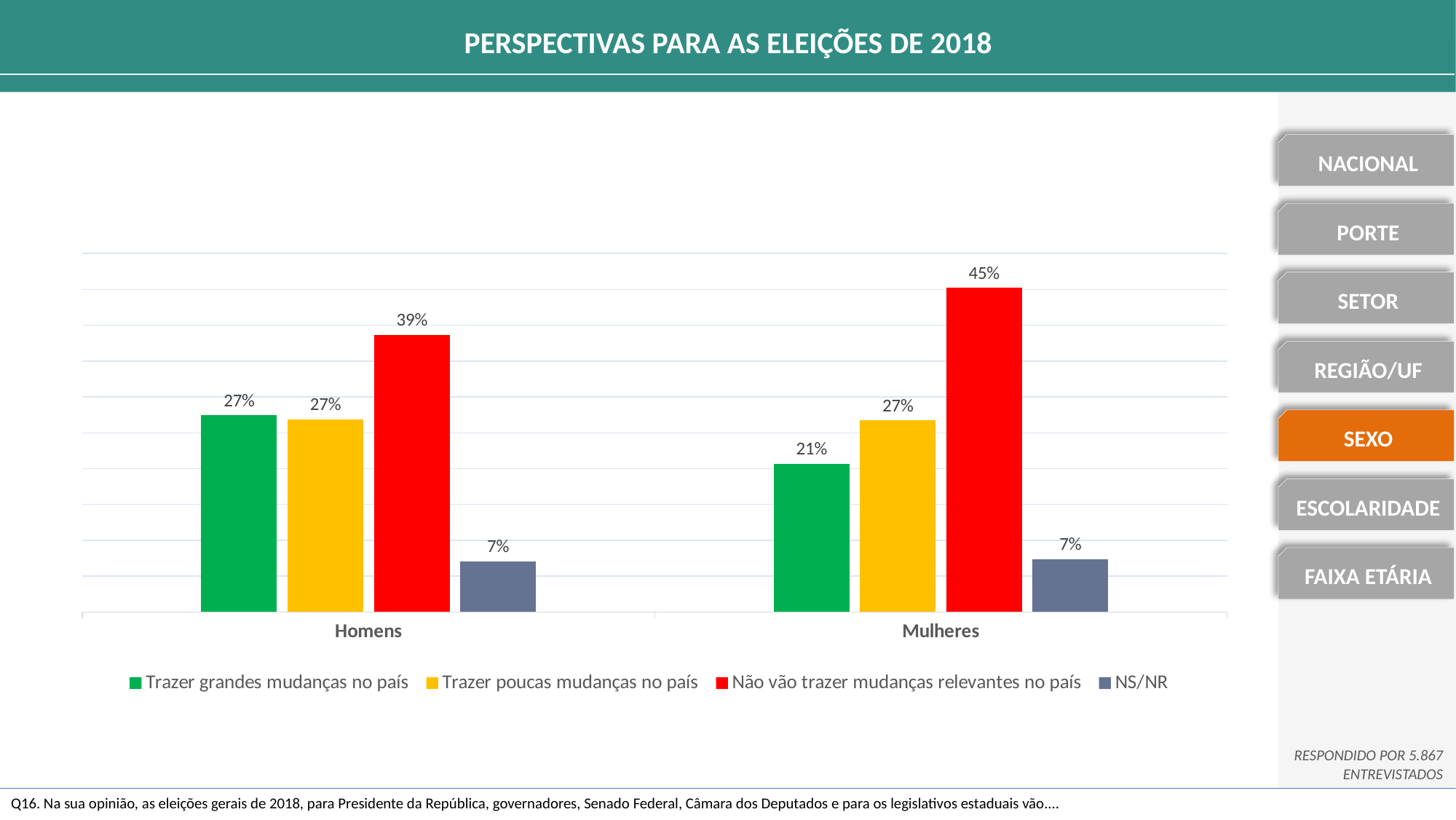
Which series has the highest value for Mulheres? Não vão trazer mudanças relevantes no país What is the value for "Não vão trazer mudanças relevantes no país" among Homens? 39% What is the value for NS/NR among Mulheres? 7% Which group has the larger value for "Trazer grandes mudanças no país", Homens or Mulheres? Homens What is the difference between the "Não vão trazer mudanças relevantes no país" values for Mulheres and Homens? 6% What is the value for "Trazer grandes mudanças no país" among Mulheres? 21% What colour represents "Trazer poucas mudanças no país" in the chart? Yellow What is the title of the slide containing the chart? PERSPECTIVAS PARA AS ELEIÇÕES DE 2018 Which series has the lowest value for Homens? NS/NR How many series does the legend list? 4 How many categories are shown on the x axis? 2 What kind of chart is shown on the slide? Bar chart